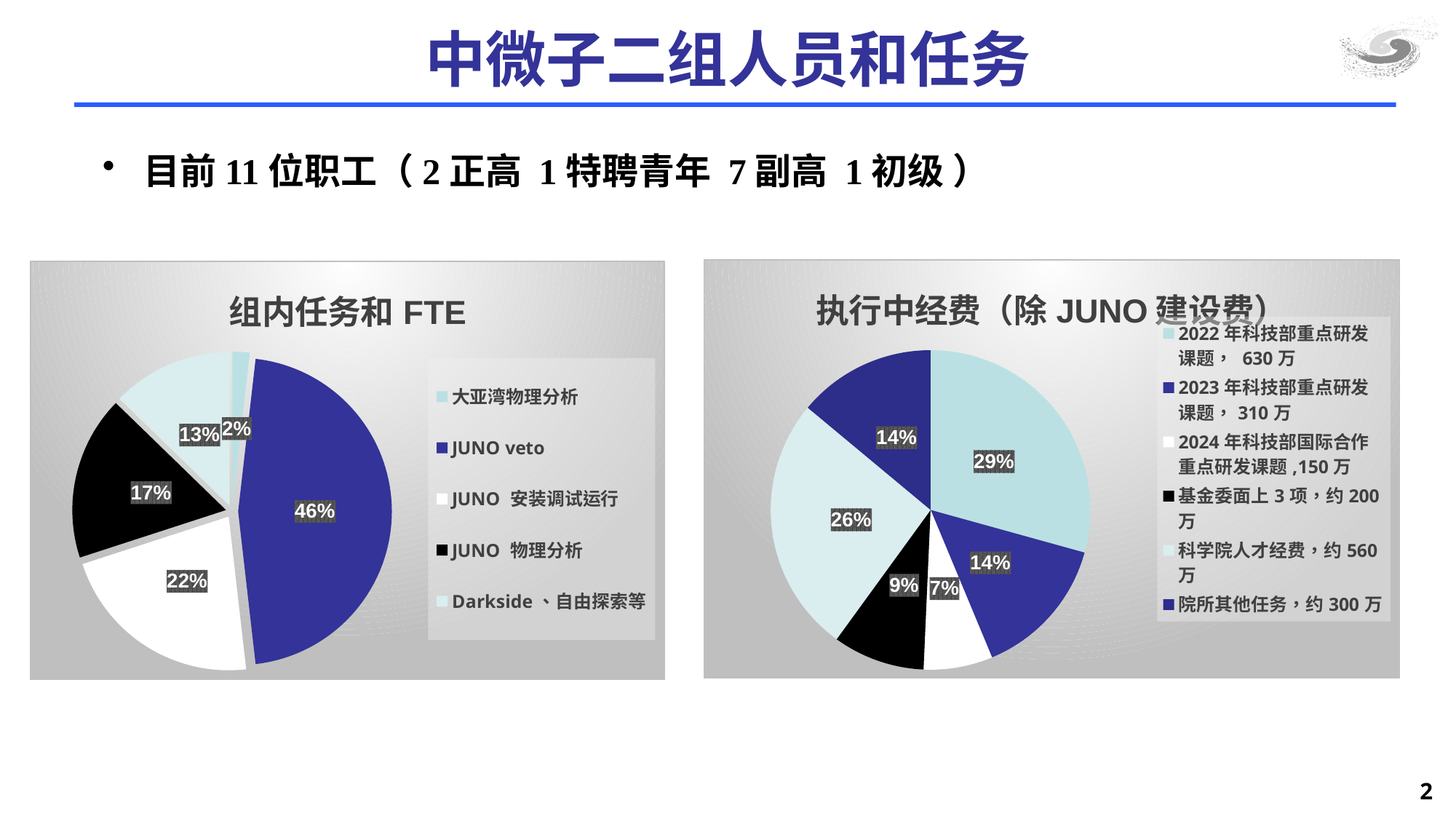
In the left pie chart titled 组内任务和 FTE, what share does JUNO 安装调试运行 have? 22% In the left pie chart titled 组内任务和 FTE, which category has the smallest share? 大亚湾物理分析 In the left pie chart titled 组内任务和 FTE, what share does JUNO veto have? 46% In the left pie chart titled 组内任务和 FTE, what share does JUNO 物理分析 have? 17% In the right pie chart titled 执行中经费（除 JUNO 建设费）, what share does 2022 年科技部重点研发课题 have? 29% In the right pie chart titled 执行中经费（除 JUNO 建设费）, which category has the smallest share? 2024 年科技部国际合作重点研发课题 In the left pie chart titled 组内任务和 FTE, how many categories does the legend list? 5 In the right pie chart titled 执行中经费（除 JUNO 建设费）, what share does 科学院人才经费 have? 26% In the left pie chart titled 组内任务和 FTE, what is the difference in percentage points between JUNO veto and JUNO 安装调试运行? 24 In the left pie chart titled 组内任务和 FTE, which category has the largest share? JUNO veto In the right pie chart titled 执行中经费（除 JUNO 建设费）, which is larger: the share for 基金委面上 3 项 or the share for 2024 年科技部国际合作重点研发课题? 基金委面上 3 项 What type of chart is used on the right side of the slide? Pie chart